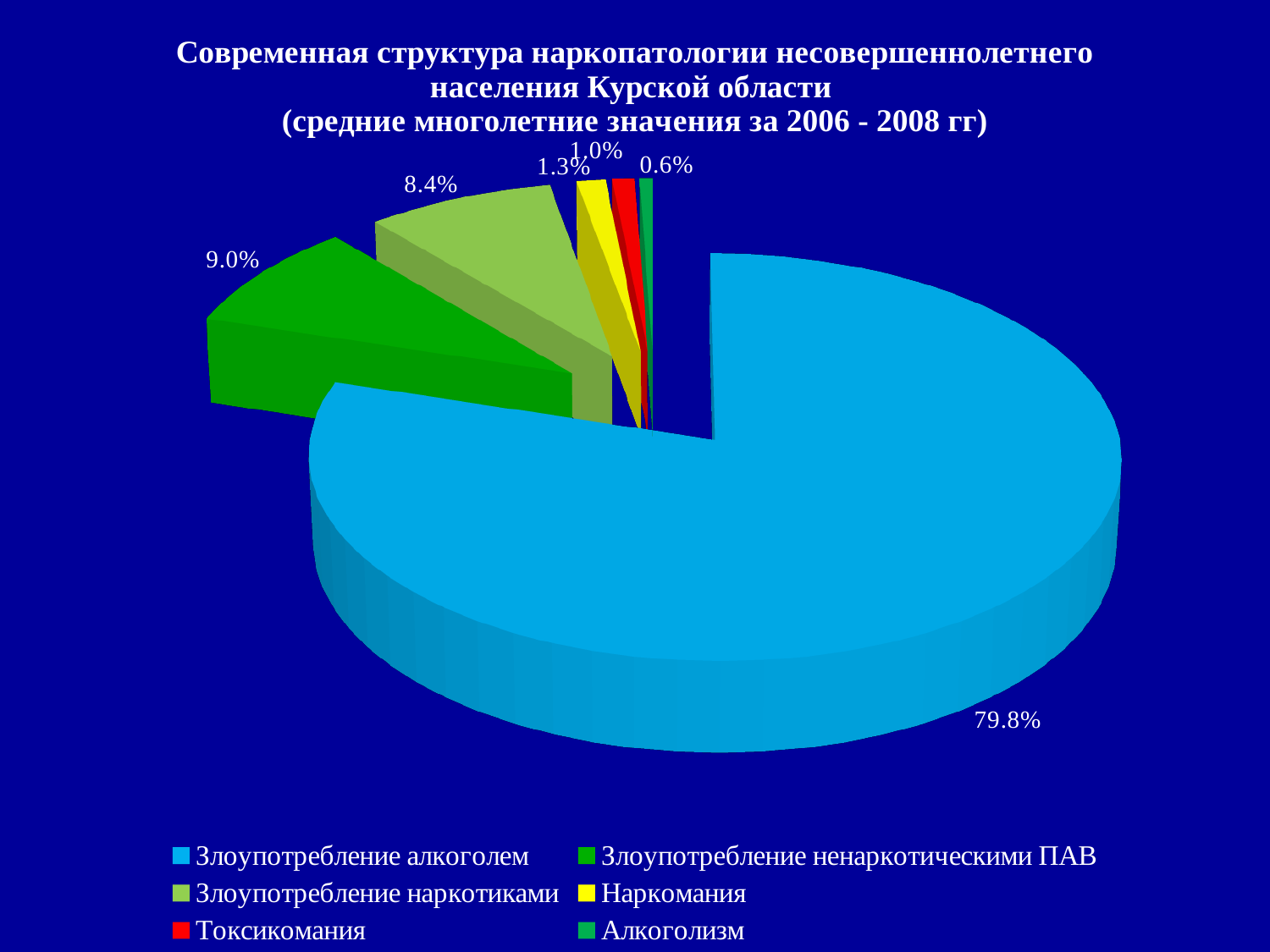
What is the value for Наркомания? 1.3% Which category has the smallest slice of the pie? Алкоголизм How many categories does the pie chart have? 6 What is the value for Токсикомания? 1.0% What is the difference between the values for Злоупотребление ненаркотическими ПАВ and Злоупотребление наркотиками? 0.6% Which category has the largest slice of the pie? Злоупотребление алкоголем What colour is the slice for Токсикомания? red What is the value for Алкоголизм? 0.6% What is the value for Злоупотребление наркотиками? 8.4% What kind of chart is shown on the slide? pie chart What is the value for Злоупотребление ненаркотическими ПАВ? 9.0% What share of the pie does Злоупотребление алкоголем have? 79.8%